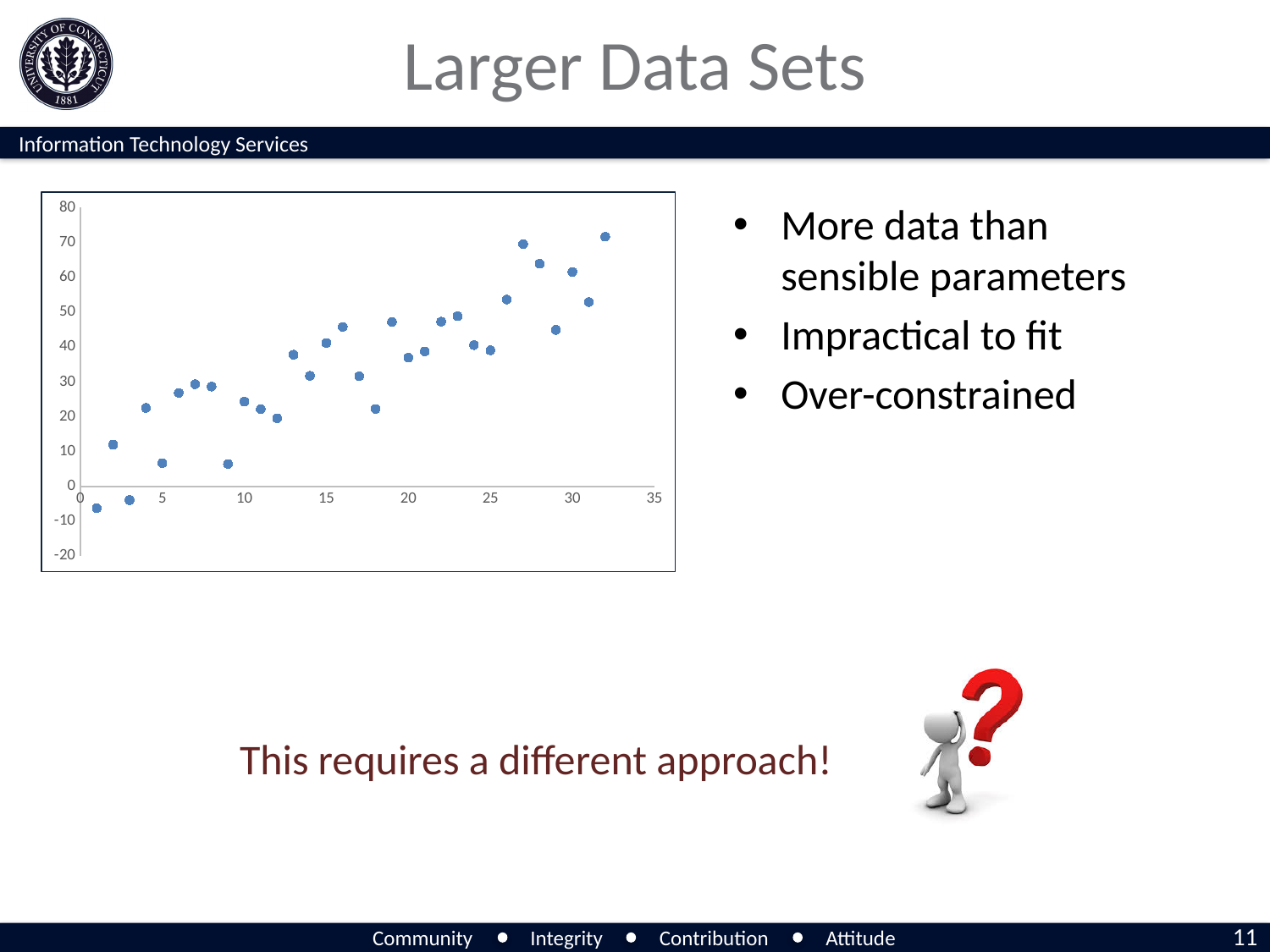
Is the value of the point at x = 27 greater or less than 60? greater Is the value of the point at x = 26 greater or less than 50? greater Is the value of the point at x = 5 greater or less than 10? less What is the lowest tick value shown on the y axis? -20 Do the plotted values generally rise or fall as x increases along the x axis? rise What kind of chart is shown on the slide? scatter chart What is the highest tick value shown on the x axis? 35